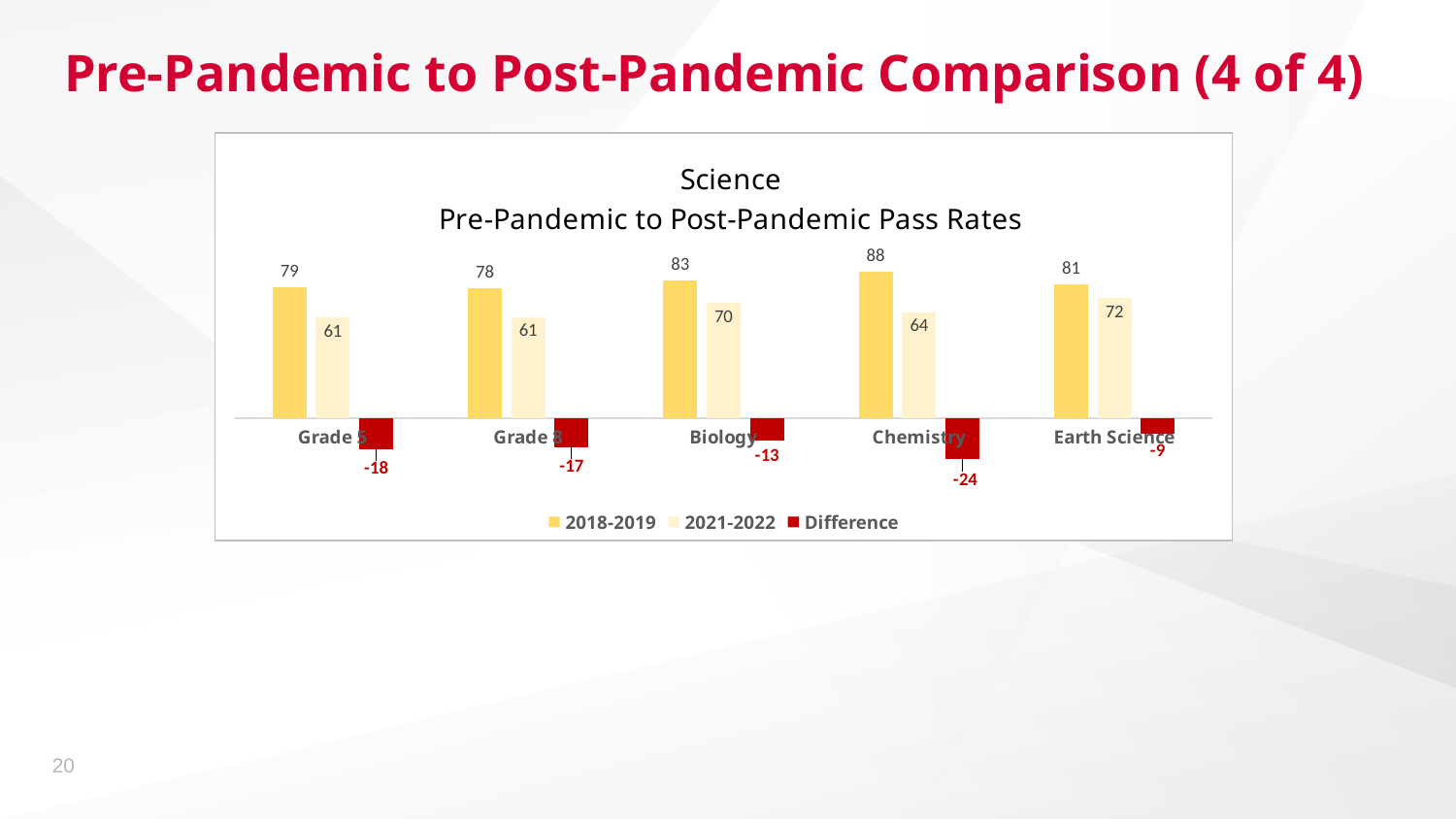
Which is larger, the 2021-2022 pass rate for Earth Science or for Chemistry? Earth Science Which category has the lowest 2021-2022 pass rate? Grade 5 and Grade 8 (both 61) What is the 2021-2022 pass rate for Biology? 70 Which category shows the largest drop (most negative Difference)? Chemistry How many categories are shown on the x axis? 5 What is the 2018-2019 pass rate for Chemistry? 88 How many series does the legend list? 3 What type of chart is shown on the slide? Bar chart What is the difference between the 2018-2019 and 2021-2022 pass rates for Grade 8? 17 What is the title of the chart? Science Pre-Pandemic to Post-Pandemic Pass Rates What is the Difference value shown for Earth Science? -9 Which category has the highest 2018-2019 pass rate? Chemistry